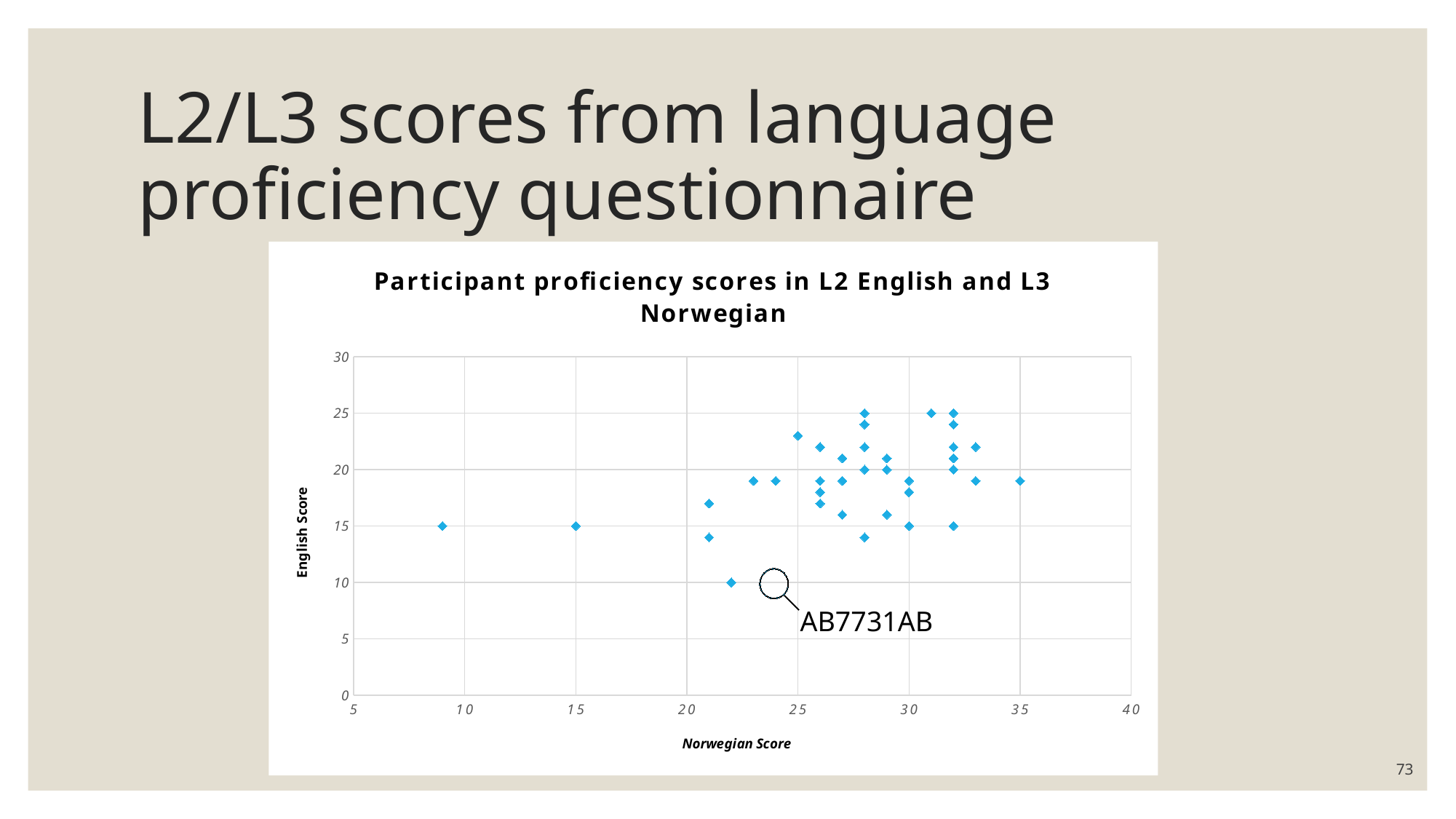
Is the Norwegian score of the leftmost point greater or less than 10? less Is the English score of the leftmost point greater or less than 20? less What is the highest English score plotted on the chart? 25 What participant label is annotated on the chart? AB7731AB What is the English score of the point plotted at a Norwegian score of 15? 15 What is the title of the chart? Participant proficiency scores in L2 English and L3 Norwegian Which is larger: the English score of the point at Norwegian score 15, or the English score of the lowest point on the chart? the point at Norwegian score 15 What kind of chart is shown on the slide? scatter chart What is the lowest English score among the points plotted at a Norwegian score of 30? 15 Is the English score of the lowest point on the chart greater or less than 15? less What is the lowest English score plotted on the chart? 10